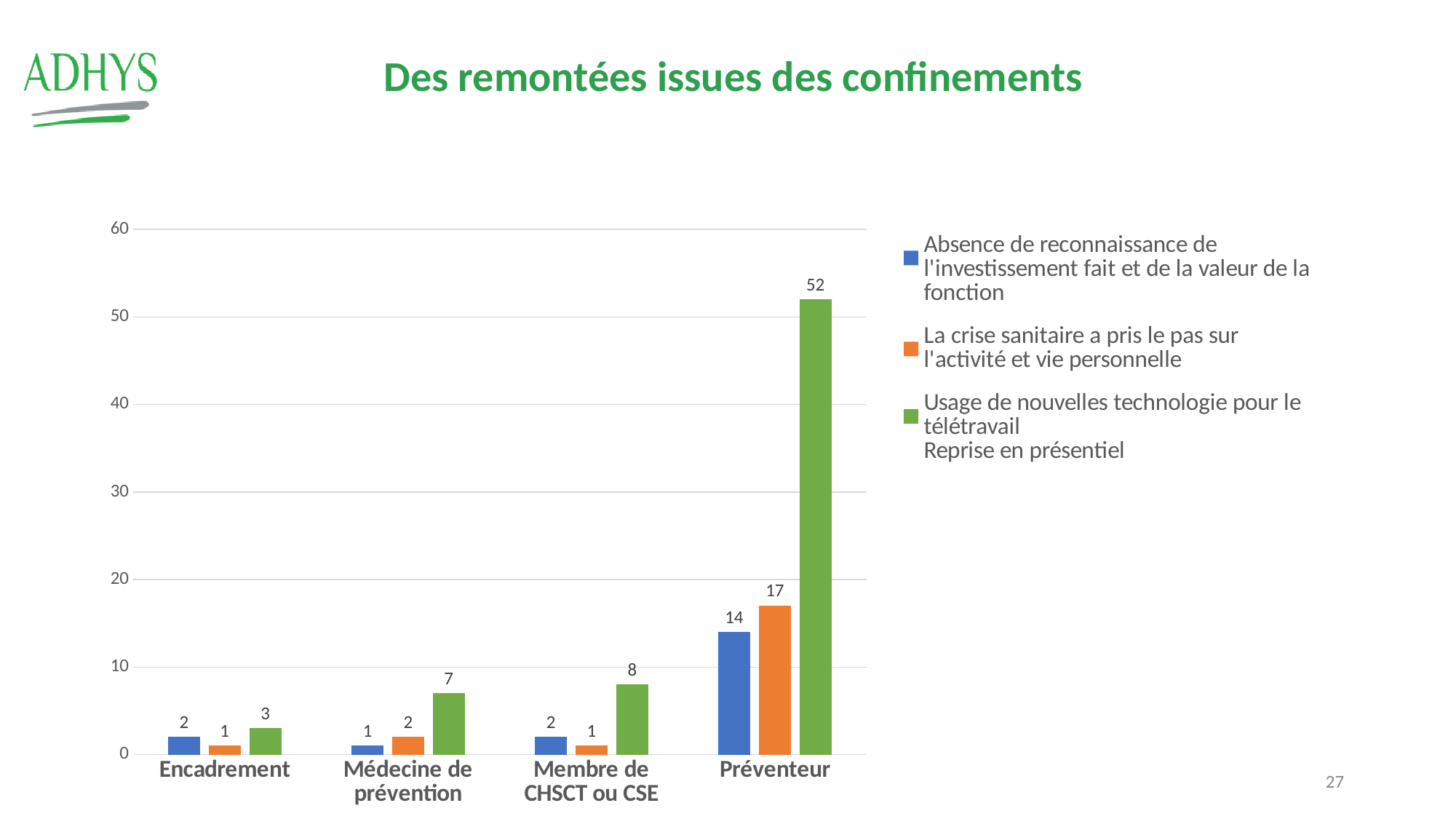
How many series does the legend list? 3 What is the value for Médecine de prévention in the 'La crise sanitaire a pris le pas sur l'activité et vie personnelle' series? 2 Is the value for Préventeur in the 'Usage de nouvelles technologie pour le télétravail' series greater or less than 50? greater What is the title of the slide? Des remontées issues des confinements What kind of chart is shown on the slide? bar chart What is the value for Membre de CHSCT ou CSE in the 'Absence de reconnaissance de l'investissement fait et de la valeur de la fonction' series? 2 Which category has the lowest value in the 'Usage de nouvelles technologie pour le télétravail' series? Encadrement How many categories are shown on the x axis? 4 What is the difference between the 'La crise sanitaire' value and the 'Absence de reconnaissance' value for Préventeur? 3 What is the value for Préventeur in the 'Usage de nouvelles technologie pour le télétravail' series? 52 Which category has the highest value in the 'Usage de nouvelles technologie pour le télétravail' series? Préventeur For Préventeur, which is larger: the 'Usage de nouvelles technologie pour le télétravail' value or the 'La crise sanitaire' value? Usage de nouvelles technologie pour le télétravail